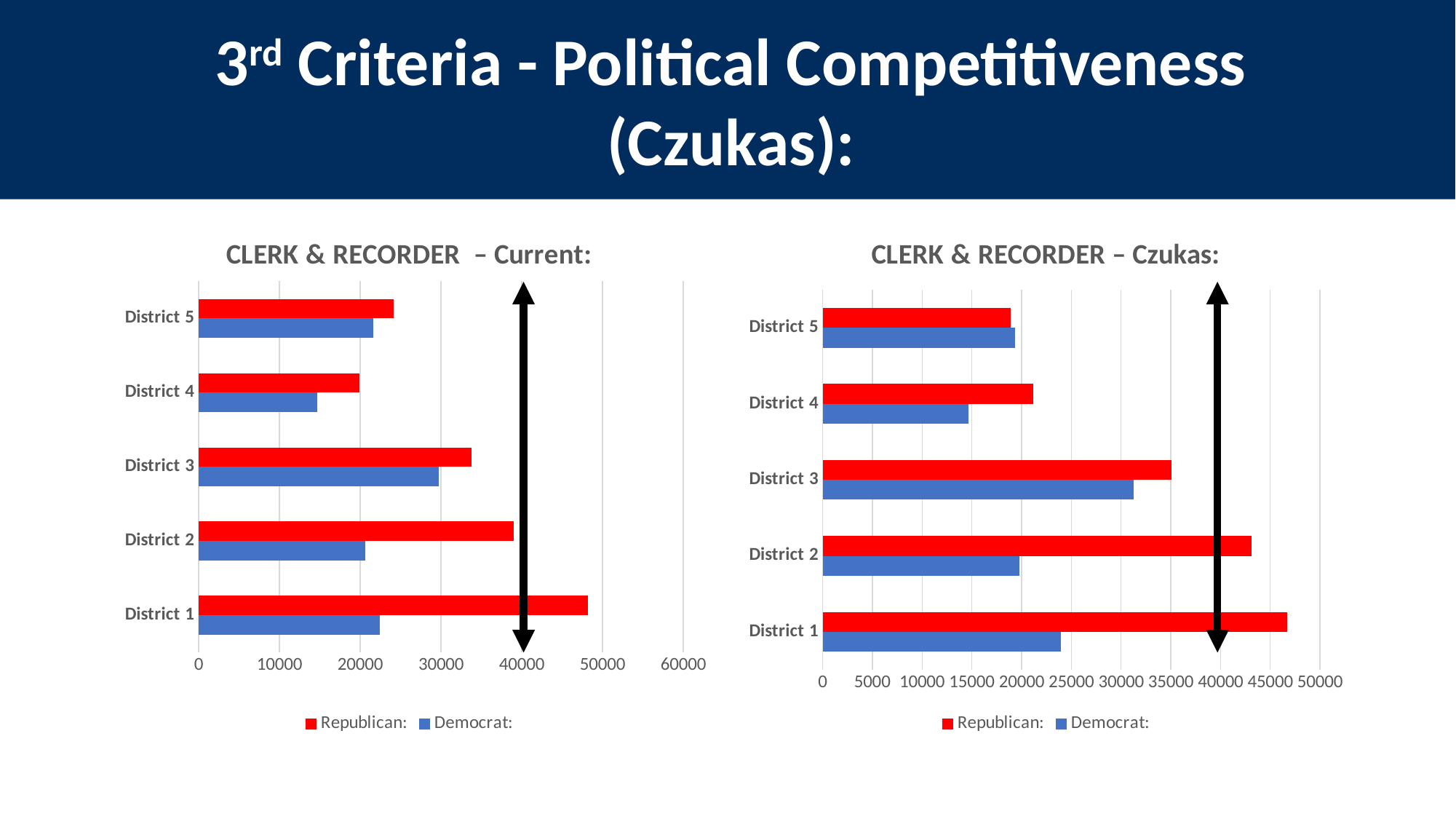
In the 'CLERK & RECORDER – Czukas:' chart, is the Republican value for District 2 greater or less than 40000? greater What are the two legend entries in the 'CLERK & RECORDER – Czukas:' chart? Republican and Democrat What kind of chart is the 'CLERK & RECORDER – Current:' chart? bar chart In the 'CLERK & RECORDER – Current:' chart, is the Republican value for District 1 greater or less than 40000? greater In the 'CLERK & RECORDER – Current:' chart, which is larger for District 3, the Republican or the Democrat value? Republican In the 'CLERK & RECORDER – Current:' chart, which district has the highest Republican value? District 1 In the 'CLERK & RECORDER – Current:' chart, which district has the lowest Democrat value? District 4 In the 'CLERK & RECORDER – Czukas:' chart, which is larger for District 2, the Republican or the Democrat value? Republican How many series does the legend of the 'CLERK & RECORDER – Current:' chart list? 2 In the 'CLERK & RECORDER – Czukas:' chart, which district has the lowest Republican value? District 5 In the 'CLERK & RECORDER – Czukas:' chart, which district has the highest Republican value? District 1 How many districts are shown in the 'CLERK & RECORDER – Current:' chart? 5